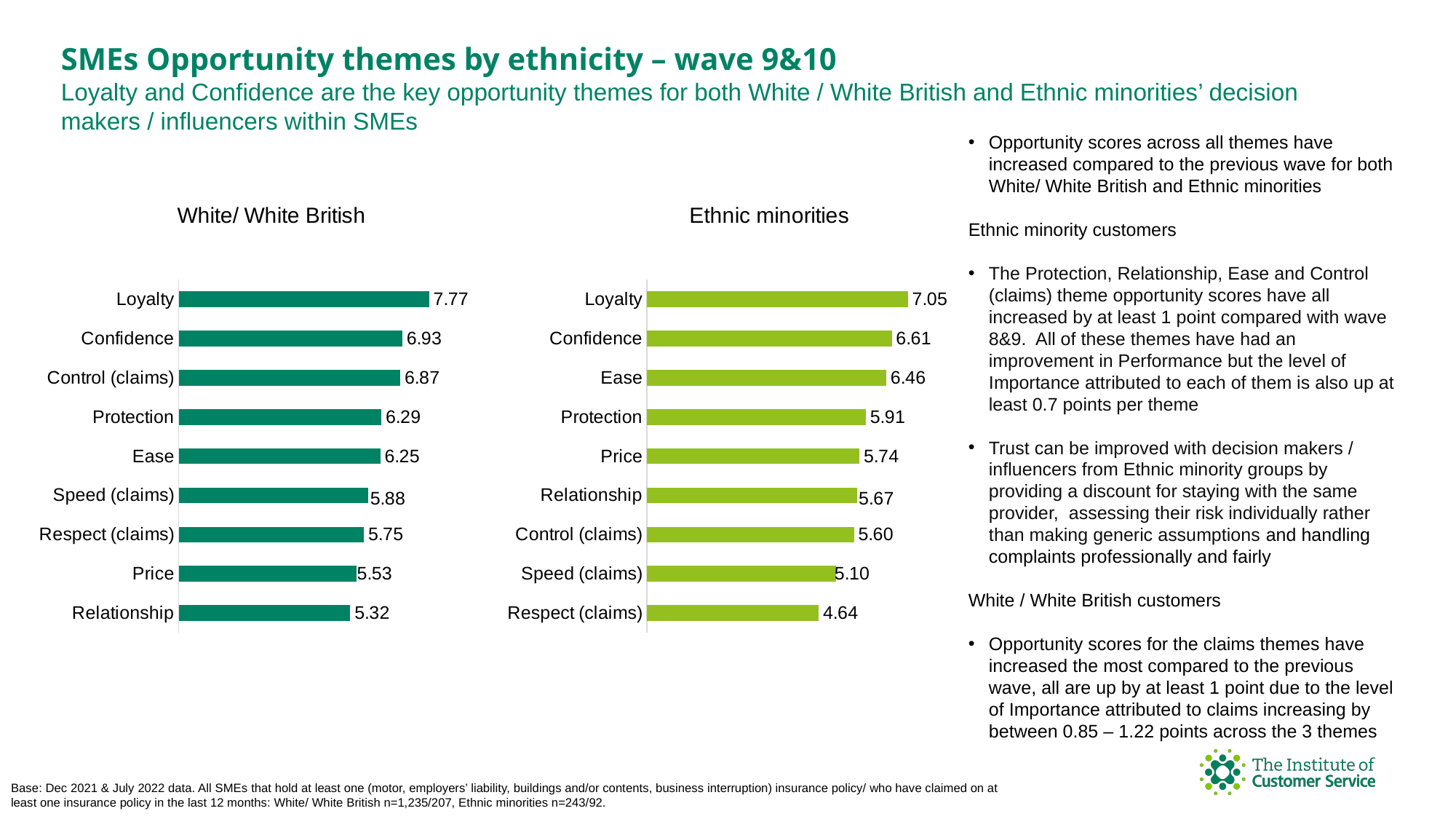
Which is larger: Control (claims) in the White/ White British chart or Control (claims) in the Ethnic minorities chart? White/ White British What kind of chart is the Ethnic minorities chart? Bar chart In the White/ White British chart, what is the value for Loyalty? 7.77 In the Ethnic minorities chart, what is the difference between Confidence and Speed (claims)? 1.51 How many themes are shown in the White/ White British chart? 9 What colour are the bars in the Ethnic minorities chart? Light green In the White/ White British chart, what is the value for Price? 5.53 In the White/ White British chart, which theme has the lowest value? Relationship In the Ethnic minorities chart, which theme has the lowest value? Respect (claims) In the White/ White British chart, what is the difference between Loyalty and Relationship? 2.45 In the Ethnic minorities chart, which theme has the highest value? Loyalty In the Ethnic minorities chart, what is the value for Ease? 6.46